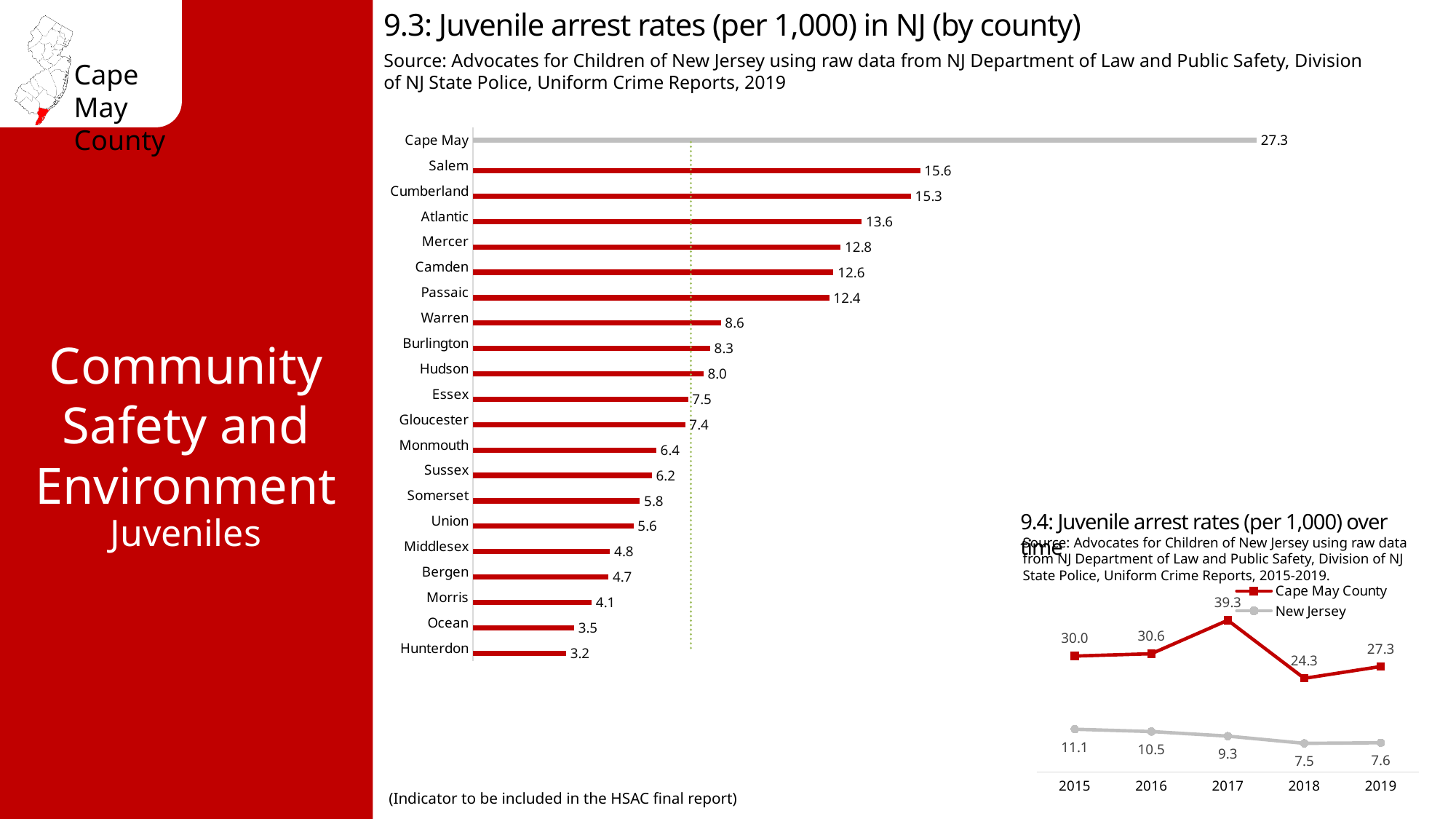
What type of chart is chart 9.3 (Juvenile arrest rates by county)? Bar chart In chart 9.4 (Juvenile arrest rates over time), how many series does the legend list? 2 In chart 9.3 (Juvenile arrest rates by county), how many counties are shown? 21 In chart 9.3 (Juvenile arrest rates by county), what is the value for Atlantic? 13.6 In chart 9.4 (Juvenile arrest rates over time), does the New Jersey series rise or fall from 2015 to 2019? Fall In chart 9.3 (Juvenile arrest rates by county), which has a higher value, Warren or Monmouth? Warren In chart 9.3 (Juvenile arrest rates by county), which county has the highest juvenile arrest rate? Cape May In chart 9.3 (Juvenile arrest rates by county), what is the difference between the values for Salem and Cumberland? 0.3 In chart 9.3 (Juvenile arrest rates by county), which county has the lowest juvenile arrest rate? Hunterdon In chart 9.3 (Juvenile arrest rates by county), what is the juvenile arrest rate for Cape May? 27.3 In chart 9.4 (Juvenile arrest rates over time), what was the Cape May County value in 2017? 39.3 In chart 9.4 (Juvenile arrest rates over time), what was the New Jersey value in 2019? 7.6